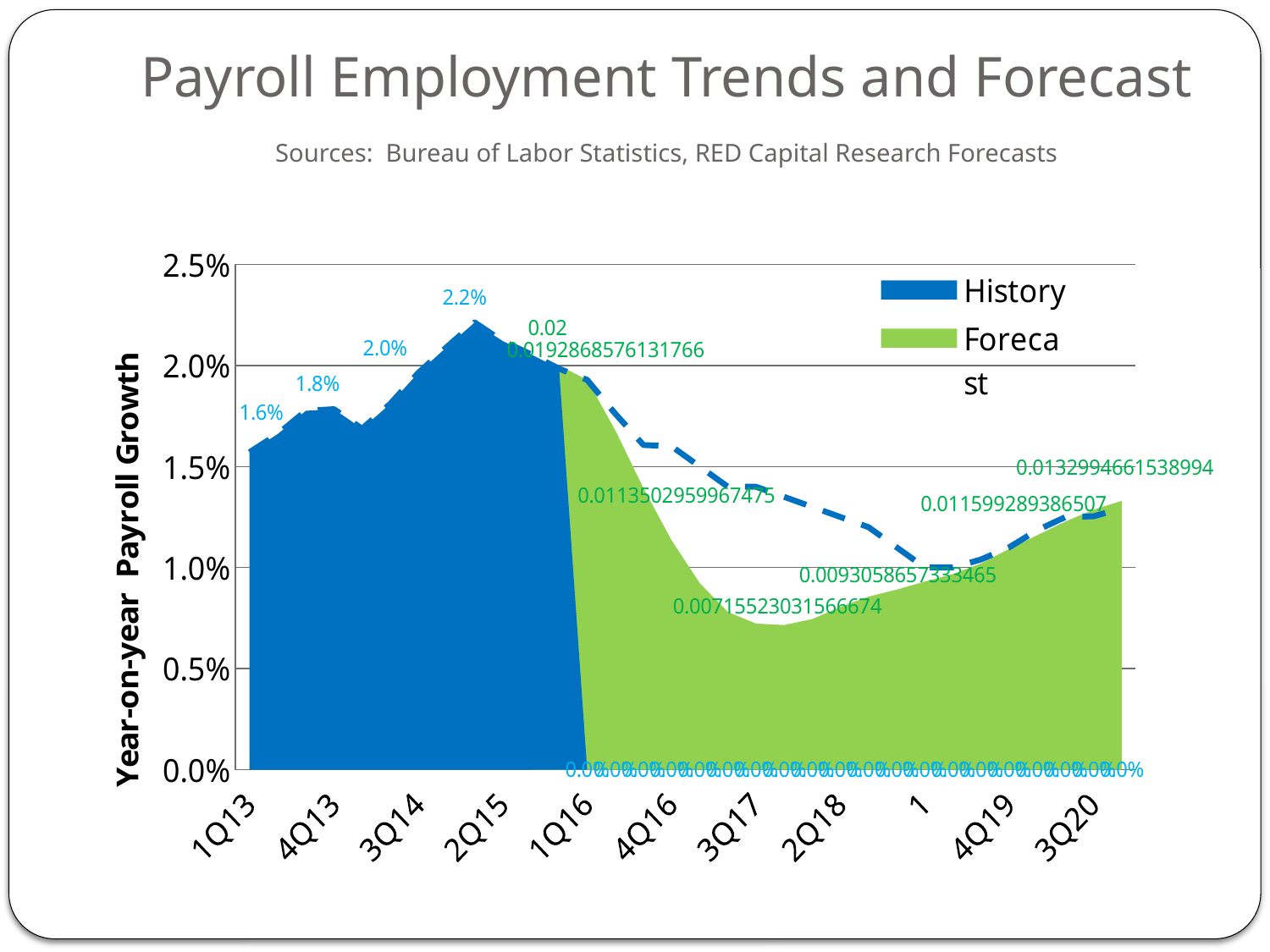
Is the value for 1Q16 greater or less than 1.5%? greater What is the lowest labeled value in the Forecast series? 0.00715523031566674 What kind of chart is shown on the slide? Combination area and line chart Which two series are listed in the chart legend? History and Forecast What is the labeled value for 1Q13? 1.6% What is the label on the vertical axis of the chart? Year-on-year Payroll Growth Does the History series rise or fall between 1Q13 and 2Q15? Rise What is the highest labeled value in the History series? 2.2% Does the Forecast series rise or fall between 1Q16 and 3Q17? Fall Is the value for 2Q15 greater or less than 2.0%? greater How many series does the legend list? 2